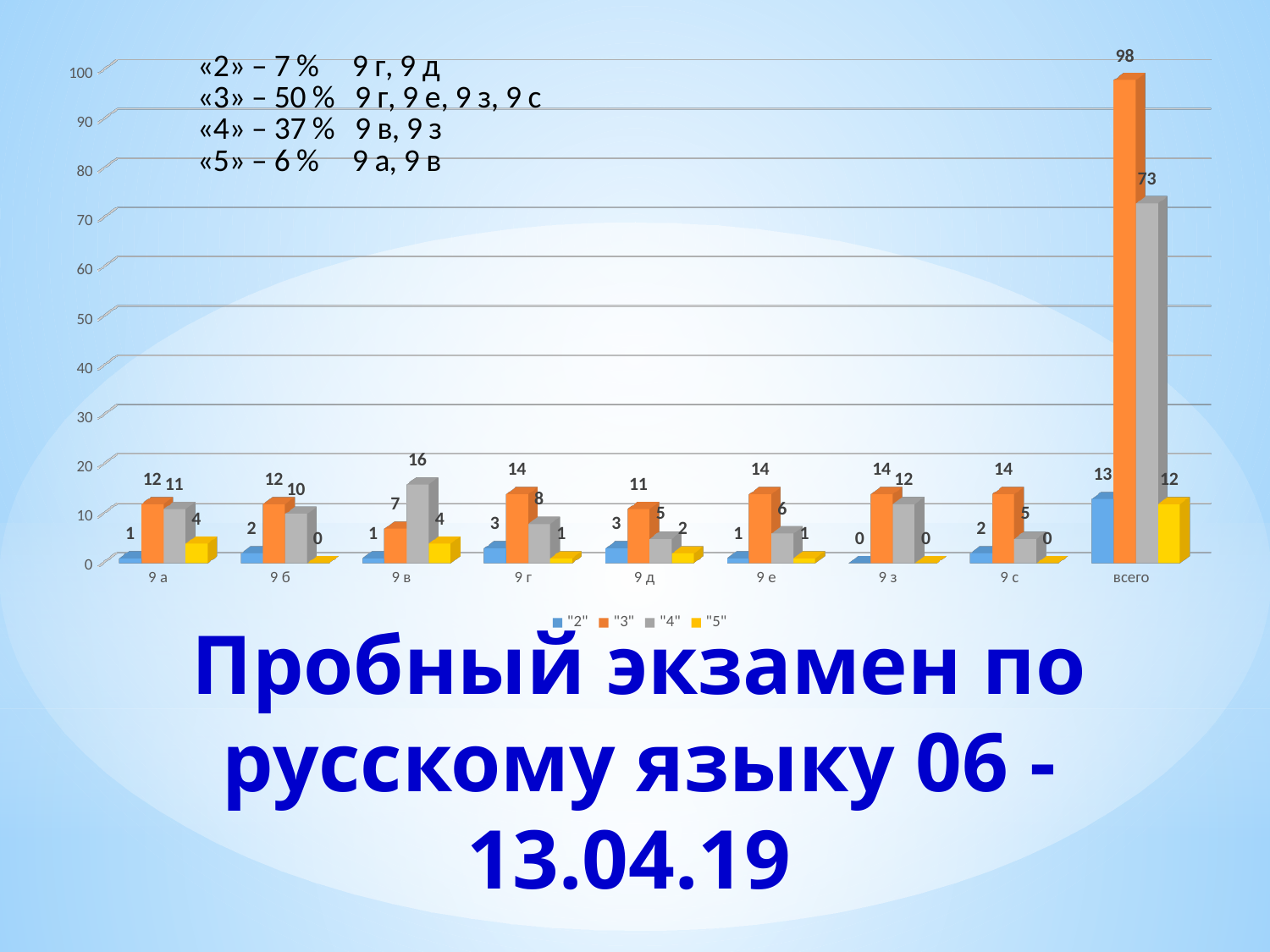
What kind of chart is shown on the slide? bar chart What is the value of series "3" for category всего? 98 What is the total of the four series for category 9 б? 24 How many categories are shown on the x axis? 9 How many series does the legend list? 4 What is the value of series "4" for category 9 в? 16 Excluding всего, which category has the highest value for series "4"? 9 в What is the difference between series "3" and series "4" for category всего? 25 What is the value of series "5" for category 9 а? 4 Which category has the highest value for series "4"? всего What is the value of series "2" for category 9 г? 3 Which is larger for category 9 д: series "3" or series "4"? series "3"